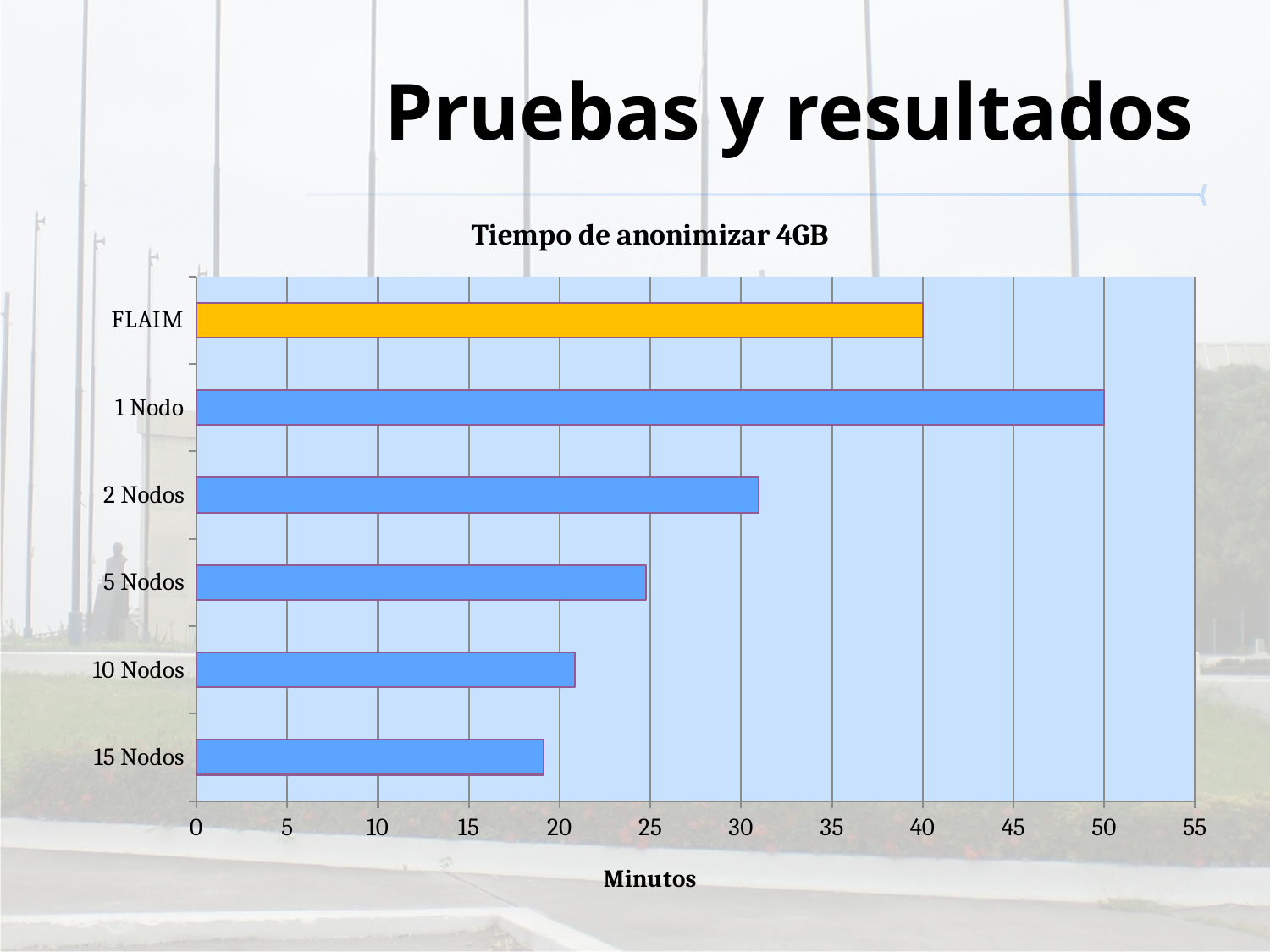
Which is larger, the value for 5 Nodos or the value for 10 Nodos? 5 Nodos What is the difference between the values for 1 Nodo and FLAIM? 10 What is the value for 1 Nodo? 50 Is the value for 15 Nodos greater or less than 20? less Which category has the highest value? 1 Nodo What type of chart is shown on the slide? bar chart Is the value for 2 Nodos greater or less than 30? greater What is the value for FLAIM? 40 What is the label of the horizontal axis? Minutos What is the title of the chart? Tiempo de anonimizar 4GB Which category has the lowest value? 15 Nodos How many categories are plotted in the chart? 6